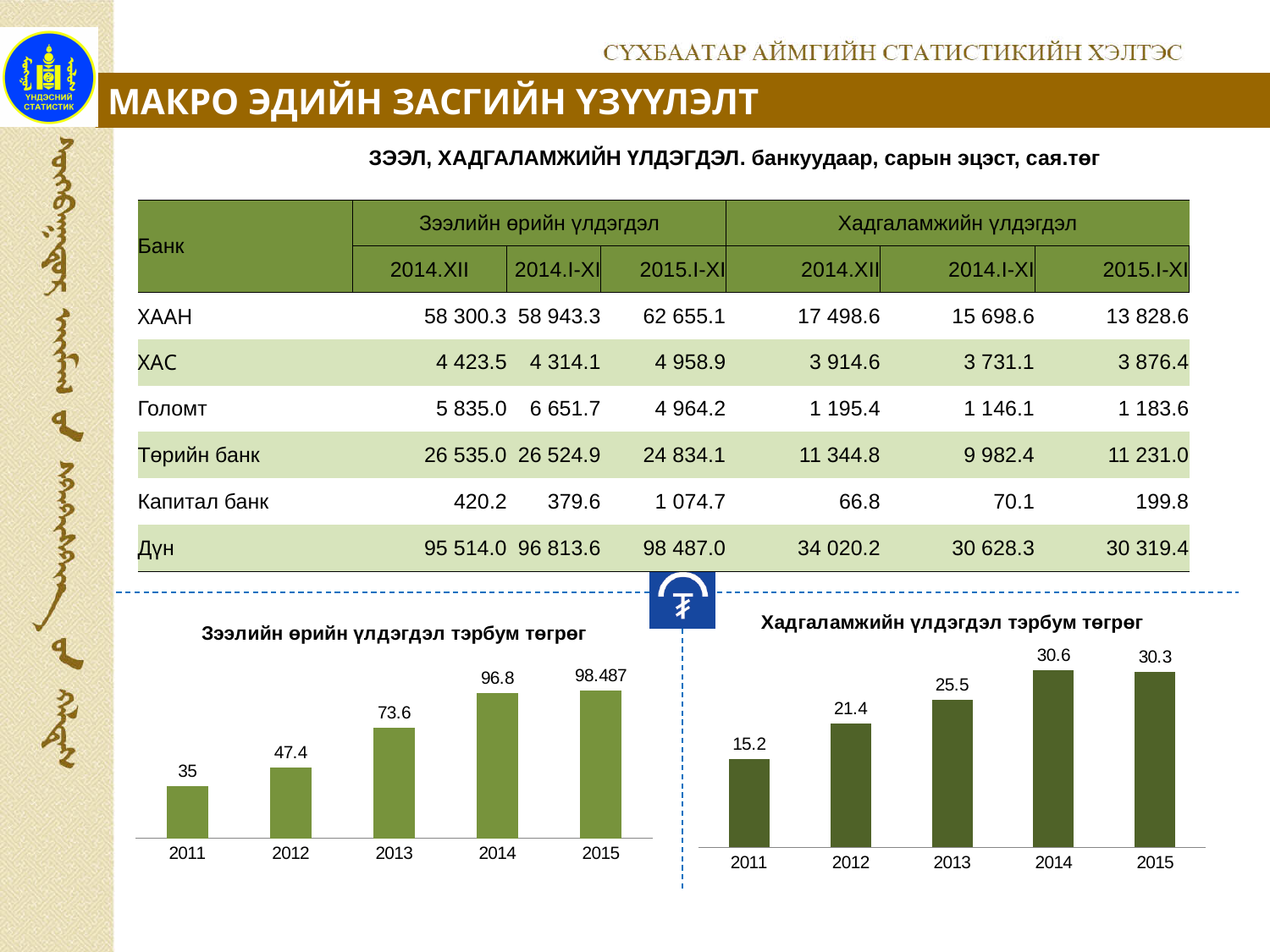
In the chart titled 'Хадгаламжийн үлдэгдэл тэрбум төгрөг', what is the value for 2012? 21.4 In the chart titled 'Хадгаламжийн үлдэгдэл тэрбум төгрөг', what is the difference between the values for 2014 and 2011? 15.4 In the chart titled 'Зээлийн өрийн үлдэгдэл тэрбум төгрөг', what is the value for 2015? 98.487 What kind of chart is the chart titled 'Хадгаламжийн үлдэгдэл тэрбум төгрөг'? Bar chart What is the title of the bar chart on the left side of the slide? Зээлийн өрийн үлдэгдэл тэрбум төгрөг In the chart titled 'Хадгаламжийн үлдэгдэл тэрбум төгрөг', which is larger, the value for 2013 or the value for 2012? 2013 In the chart titled 'Хадгаламжийн үлдэгдэл тэрбум төгрөг', which year has the highest value? 2014 In the chart titled 'Зээлийн өрийн үлдэгдэл тэрбум төгрөг', what is the difference between the values for 2013 and 2012? 26.2 How many years are shown in the chart titled 'Зээлийн өрийн үлдэгдэл тэрбум төгрөг'? 5 In the chart titled 'Зээлийн өрийн үлдэгдэл тэрбум төгрөг', do the values rise or fall from 2011 to 2015? Rise In the chart titled 'Зээлийн өрийн үлдэгдэл тэрбум төгрөг', what is the value for 2013? 73.6 In the chart titled 'Зээлийн өрийн үлдэгдэл тэрбум төгрөг', which year has the lowest value? 2011